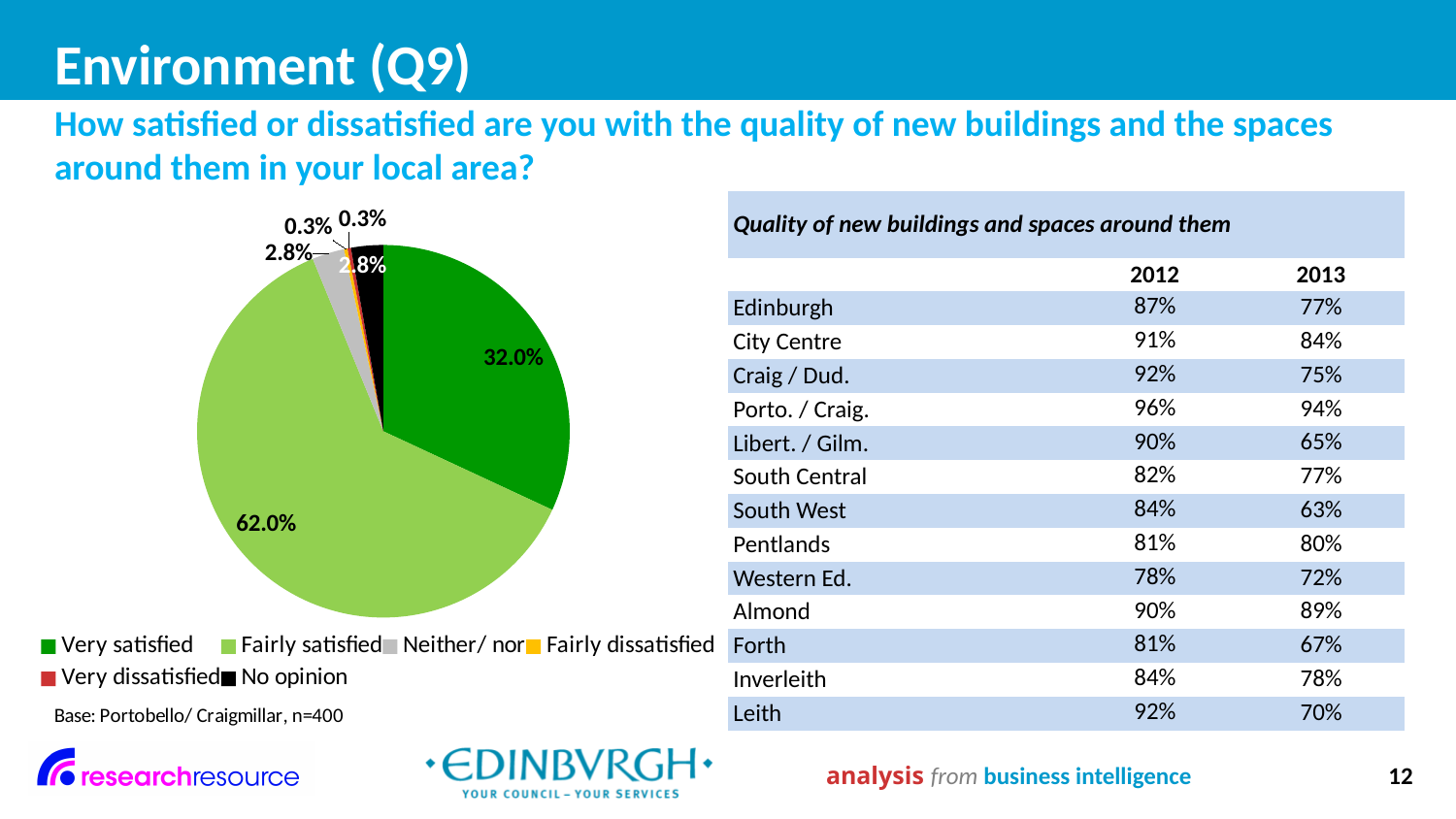
What is the base (sample size) stated for the pie chart? Portobello/ Craigmillar, n=400 What percentage of respondents were very satisfied? 32.0% Which response category has the largest share of the pie? Fairly satisfied What is the combined share of very satisfied and fairly satisfied respondents? 94.0% What percentage of respondents answered neither/nor? 2.8% How many response categories does the pie chart legend list? 6 What percentage of respondents were fairly satisfied? 62.0% Which is larger: the share for very satisfied or the share for fairly satisfied? Fairly satisfied What colour represents the very satisfied slice in the pie chart? Dark green What is the difference in percentage points between fairly satisfied and very satisfied? 30.0 percentage points What kind of chart is shown on the slide? Pie chart What percentage of respondents had no opinion? 2.8%